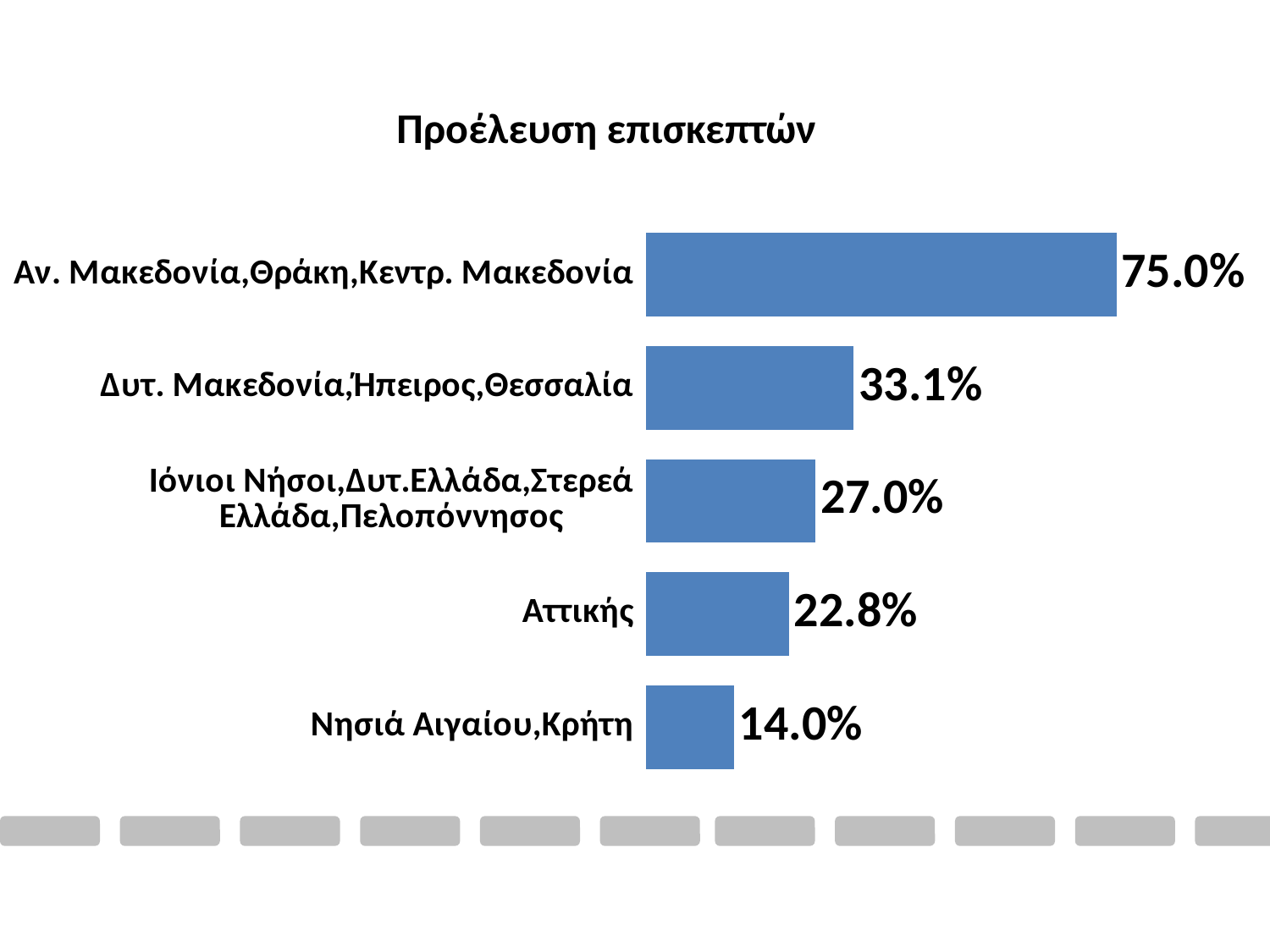
What is the value for Δυτ. Μακεδονία,Ήπειρος,Θεσσαλία? 33.1% Which is larger, the value for Αττικής or the value for Ιόνιοι Νήσοι,Δυτ.Ελλάδα,Στερεά Ελλάδα,Πελοπόννησος? Ιόνιοι Νήσοι,Δυτ.Ελλάδα,Στερεά Ελλάδα,Πελοπόννησος What is the difference between the values for Αττικής and Νησιά Αιγαίου,Κρήτη? 8.8% What is the value for Αττικής? 22.8% What is the value for Νησιά Αιγαίου,Κρήτη? 14.0% How many categories are shown in the chart? 5 What kind of chart is shown on the slide? Bar chart What is the value for Ιόνιοι Νήσοι,Δυτ.Ελλάδα,Στερεά Ελλάδα,Πελοπόννησος? 27.0% What is the title of the chart? Προέλευση επισκεπτών What is the difference between the values for Αν. Μακεδονία,Θράκη,Κεντρ. Μακεδονία and Δυτ. Μακεδονία,Ήπειρος,Θεσσαλία? 41.9% Which category has the lowest value? Νησιά Αιγαίου,Κρήτη Which category has the highest value? Αν. Μακεδονία,Θράκη,Κεντρ. Μακεδονία